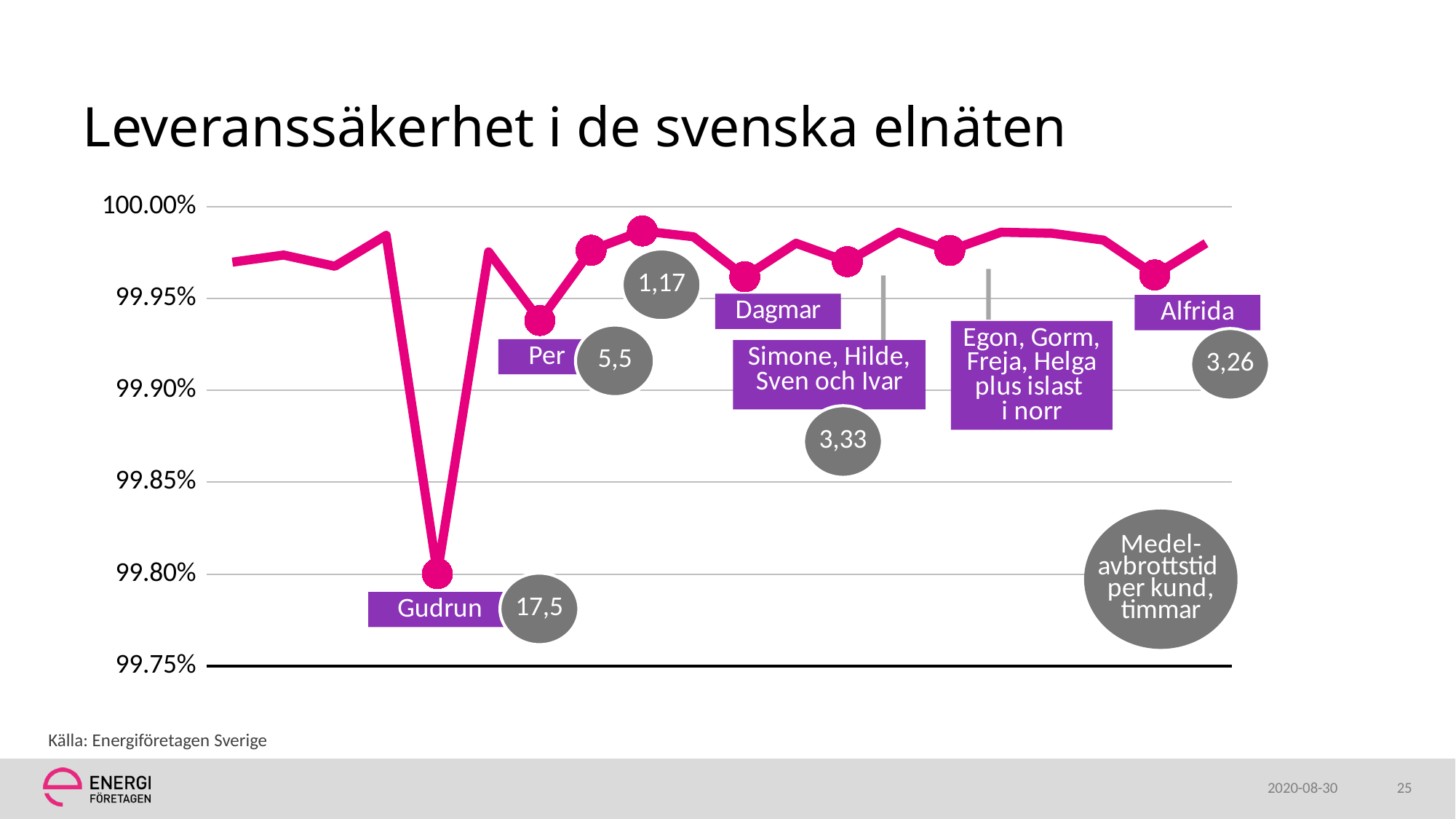
What is the average outage time per customer shown for Simone, Hilde, Sven och Ivar? 3,33 What is the average outage time per customer shown for Alfrida? 3,26 What kind of chart is shown on the slide? line chart What is the lowest value shown on the y axis? 99.75% Is the value of the line at the Per point greater or less than 99.90%? greater Is the value of the line at the Gudrun point greater or less than 99.85%? less How much larger is the average outage time for Gudrun than for Per? 12 What is the average outage time per customer shown for Per? 5,5 What is the average outage time per customer (in hours) shown for Gudrun? 17,5 Which has the larger average outage time per customer, Gudrun or Per? Gudrun Which storm is labelled at the lowest point of the line? Gudrun What is the title of the chart? Leveranssäkerhet i de svenska elnäten